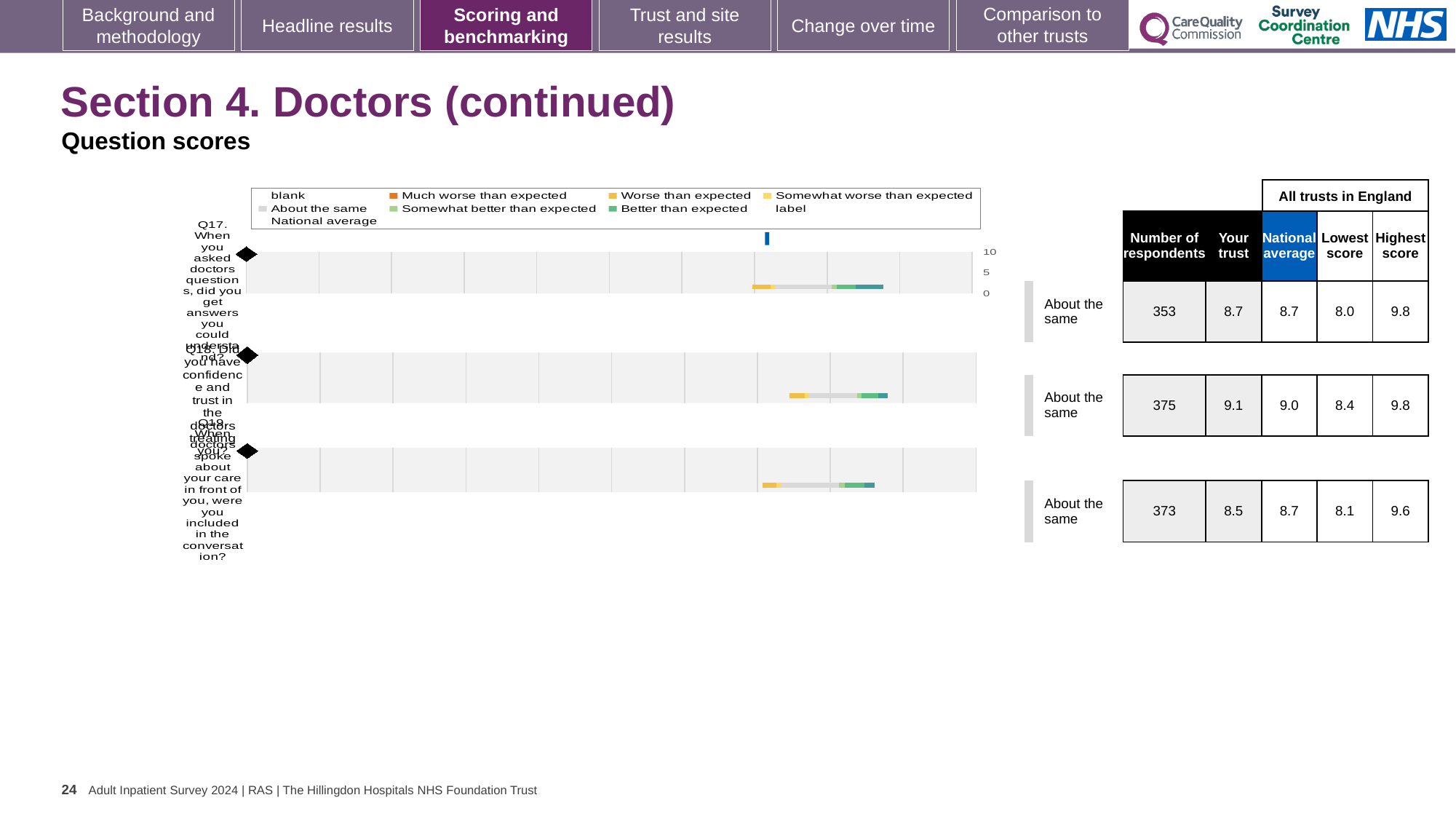
What benchmark category is shown next to the chart for Q17? About the same Which question has the highest 'Your trust' score? Q18 What is the highest score across all trusts in England for Q19? 9.6 What is the national average score for Q18 (Did you have confidence and trust in the doctors treating you?)? 9.0 What kind of chart is used to show the question scores for Q17, Q18 and Q19? bar chart What is the 'Your trust' score for Q17 (When you asked doctors questions, did you get answers you could understand?)? 8.7 What is the difference between the 'Your trust' score and the national average for Q18? 0.1 For Q19, which is larger: the 'Your trust' score or the national average? National average Which question has the lowest 'Your trust' score? Q19 How many questions (Q17, Q18, Q19) are plotted on the slide? 3 What is the number of respondents for Q19 (When doctors spoke about your care in front of you, were you included in the conversation?)? 373 Is the 'Your trust' score for Q17 greater or less than 5 on the chart axis? greater